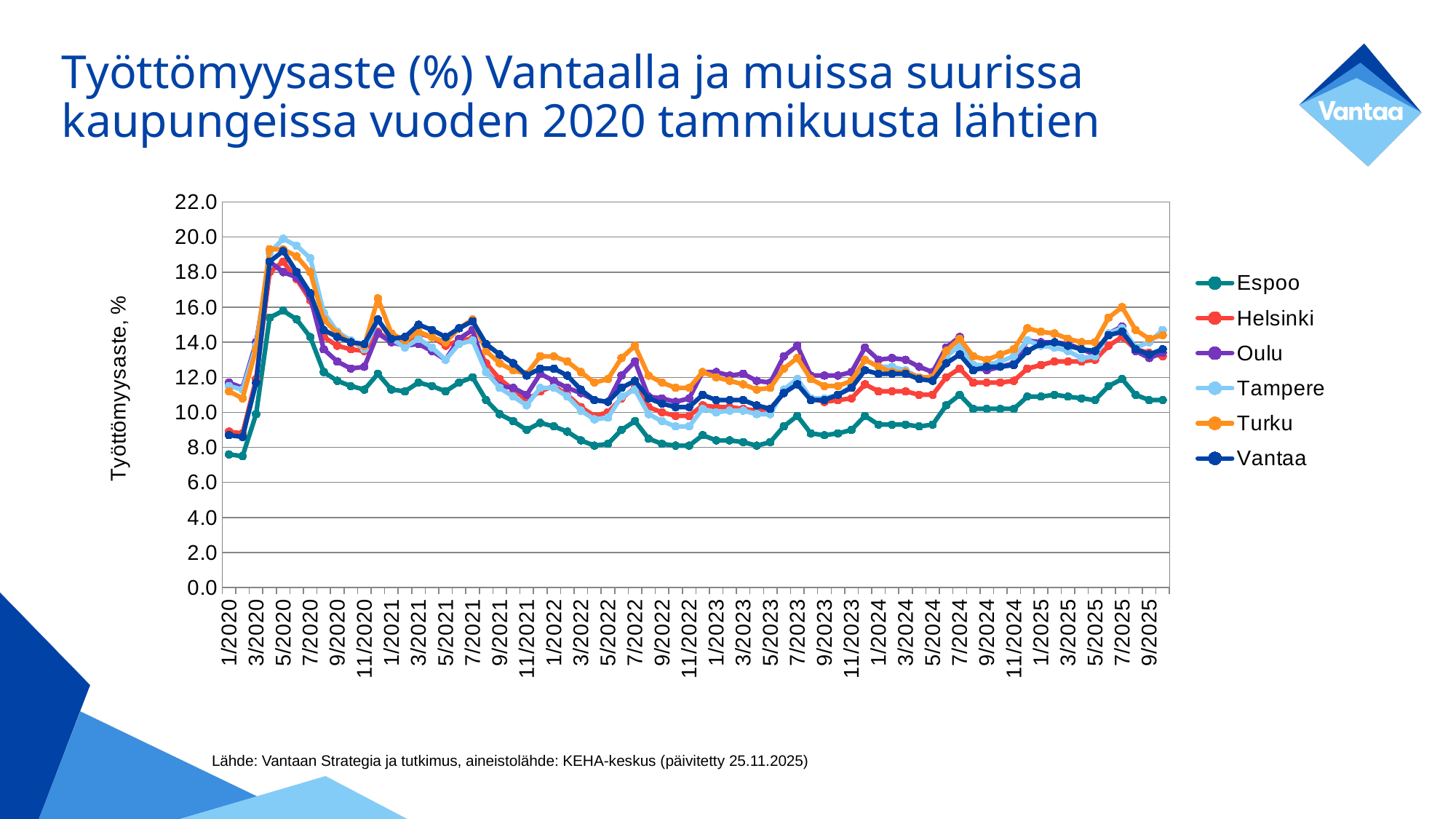
Which city has the highest unemployment rate at 7/2025? Turku What is the label of the vertical axis? Työttömyysaste, % Is the value for Espoo at 1/2020 greater or less than 8.0? less How many series does the legend list? 6 Which city's line is the lowest across the whole period shown? Espoo At 7/2025, which is larger, the value for Turku or the value for Helsinki? Turku Is the value for Espoo at 5/2022 greater or less than 10.0? less At 5/2020, which is larger, the value for Vantaa or the value for Espoo? Vantaa Does the Vantaa line rise or fall between 5/2020 and 5/2022? fall Is the value for Vantaa at 5/2020 greater or less than 18.0? greater Which city has the highest unemployment rate at the peak around 5/2020? Tampere What kind of chart is shown on the slide? line chart